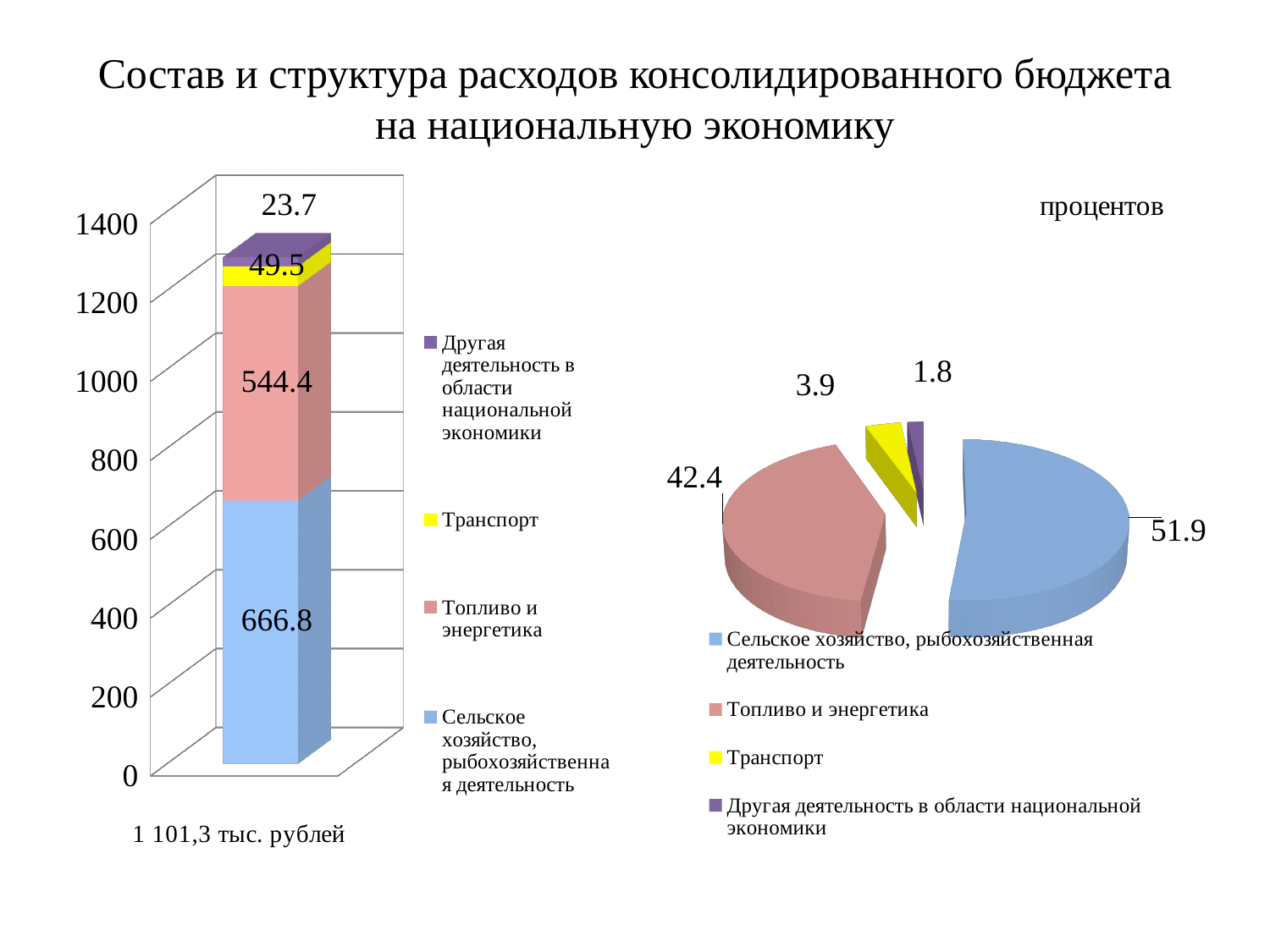
On the left stacked bar chart, what is the difference between the values for Сельское хозяйство, рыбохозяйственная деятельность and Топливо и энергетика? 122.4 On the right pie chart, what is the share for Топливо и энергетика? 42.4 On the right pie chart, what is the difference between the shares for Сельское хозяйство, рыбохозяйственная деятельность and Топливо и энергетика? 9.5 How many series does the legend of the left stacked bar chart list? 4 What kind of chart is on the right side of the slide? Pie chart On the left stacked bar chart, what is the value for Топливо и энергетика? 544.4 On the left stacked bar chart, which segment has the smallest value? Другая деятельность в области национальной экономики On the left stacked bar chart, what is the value for Сельское хозяйство, рыбохозяйственная деятельность? 666.8 On the left stacked bar chart, what is the total of all segments in the bar? 1284.4 On the right pie chart, which category has the largest slice? Сельское хозяйство, рыбохозяйственная деятельность On the right pie chart, which is larger: Транспорт or Другая деятельность в области национальной экономики? Транспорт On the left stacked bar chart, what is the value for Транспорт? 49.5